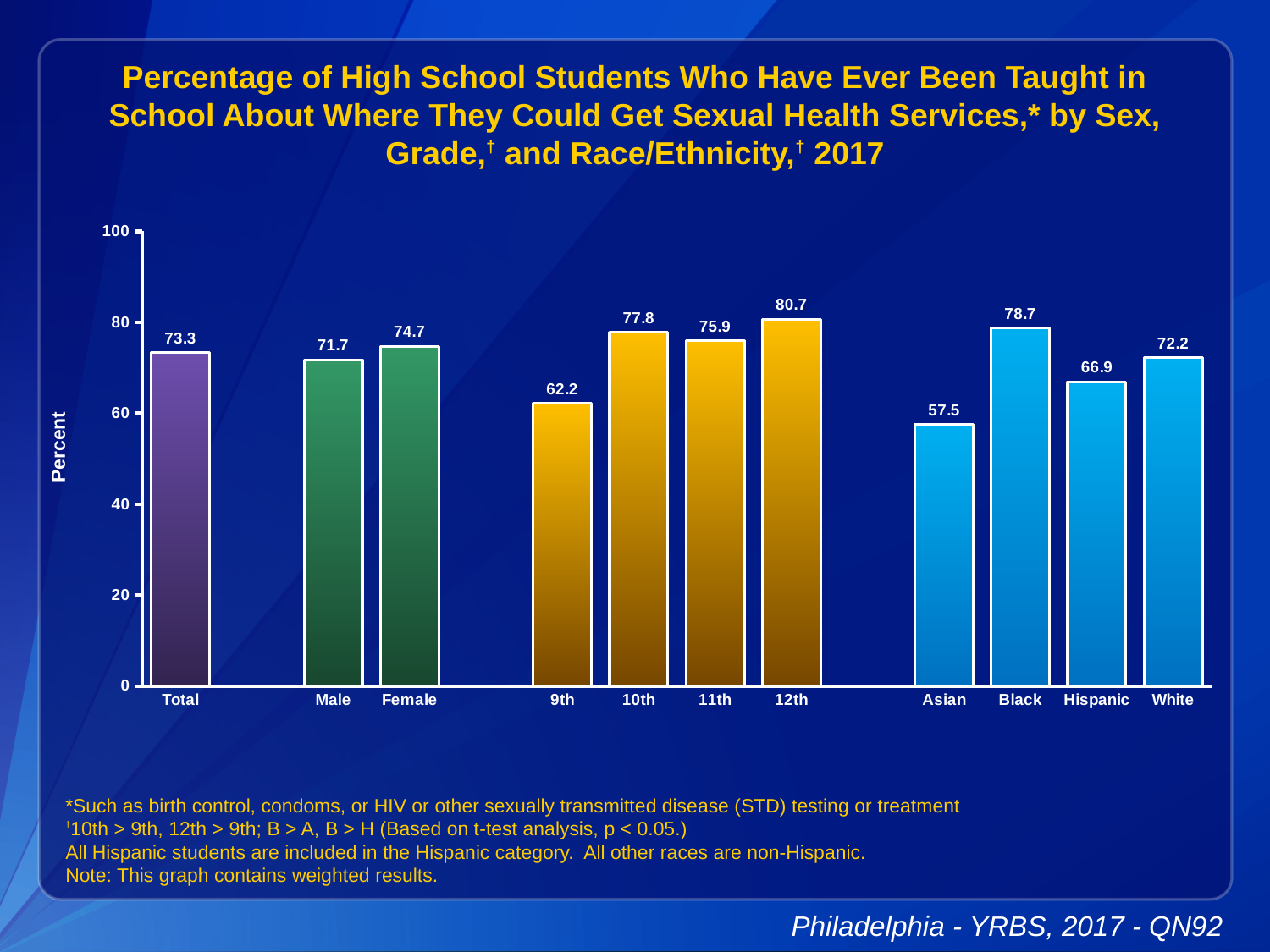
What is the value for 9th grade? 62.2 What is the value for Female? 74.7 What is the difference between the values for Female and Male? 3.0 What kind of chart is this? bar chart What is the label on the y axis? Percent Is the value for 11th grade greater or less than 80? less Which category has the lowest value? Asian What is the value for Asian? 57.5 Which is larger, the value for Black or the value for Hispanic? Black Which category has the highest value? 12th What is the value for Total? 73.3 How many categories are shown on the x axis? 11